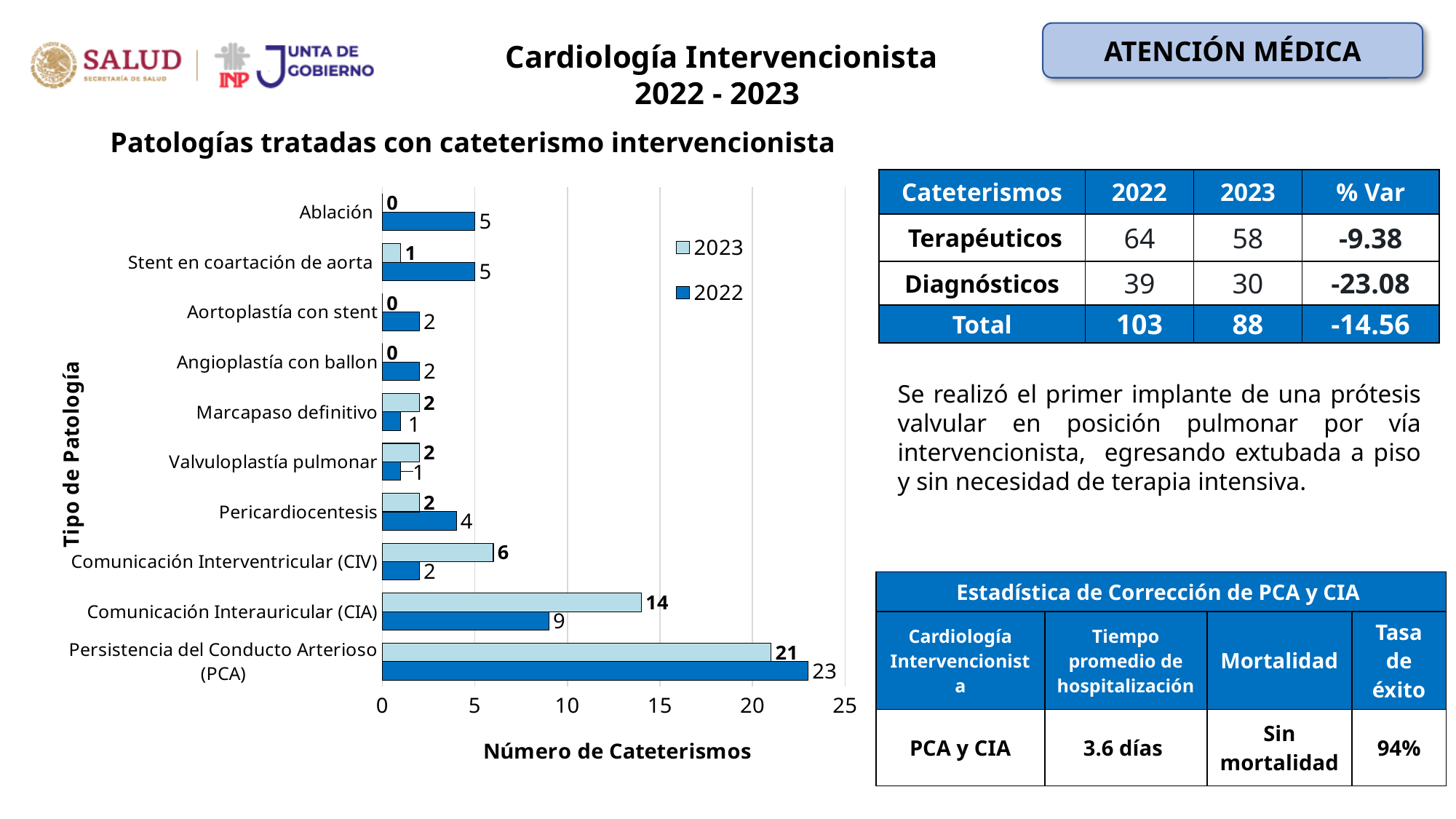
What is the difference between the 2022 and 2023 values for Comunicación Interauricular (CIA)? 5 What kind of chart is shown on the slide? bar chart What is the 2022 value for Persistencia del Conducto Arterioso (PCA)? 23 Is the 2023 value for Persistencia del Conducto Arterioso (PCA) greater or less than 20? greater How many series does the legend list? 2 Which pathology has the highest 2022 value? Persistencia del Conducto Arterioso (PCA) What is the 2023 value for Comunicación Interventricular (CIV)? 6 How many pathology categories are shown on the chart? 10 Which is larger for Pericardiocentesis, the 2022 value or the 2023 value? 2022 What is the x-axis title of the chart? Número de Cateterismos What is the 2023 value for Comunicación Interauricular (CIA)? 14 What is the 2023 value for Ablación? 0